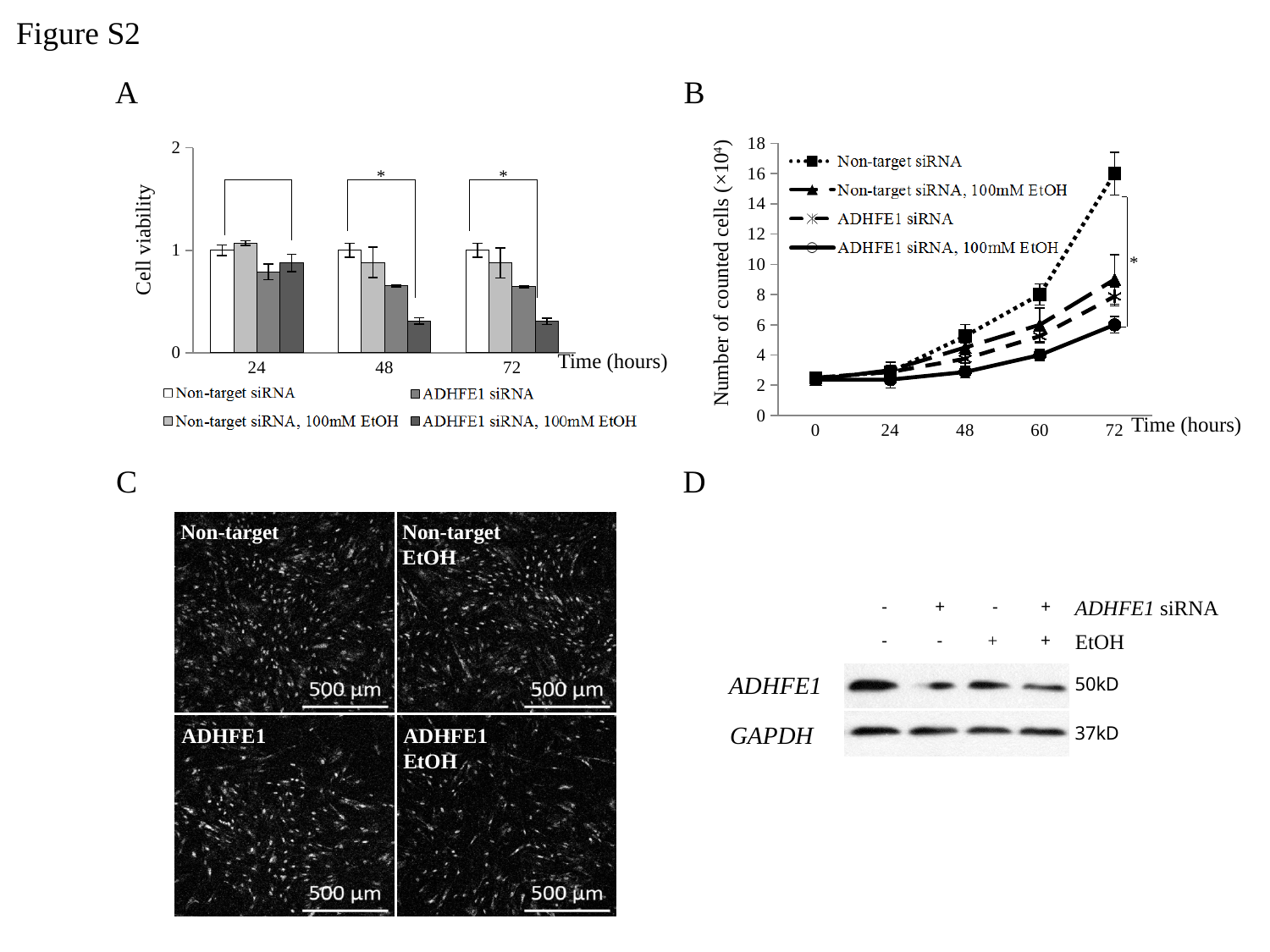
In chart B (Number of counted cells), how many time points are shown on the x axis? 5 In chart B (Number of counted cells), is the value for Non-target siRNA at 72 hours greater or less than 14? greater In chart A (Cell viability), which series has the lowest value at 72 hours? ADHFE1 siRNA, 100mM EtOH What kind of chart is chart B (Number of counted cells)? line chart In chart B (Number of counted cells), does the Non-target siRNA series rise or fall from 0 to 72 hours? rise In chart B (Number of counted cells), how many series does the legend list? 4 In chart A (Cell viability), is the value for ADHFE1 siRNA, 100mM EtOH at 48 hours greater or less than 0.5? less In chart B (Number of counted cells), which series has the highest value at 72 hours? Non-target siRNA What kind of chart is chart A (Cell viability)? bar chart In chart A (Cell viability), how many series does the legend list? 4 In chart A (Cell viability), how many time points are shown on the x axis? 3 In chart A (Cell viability), at 48 hours, which is larger: Non-target siRNA or ADHFE1 siRNA, 100mM EtOH? Non-target siRNA